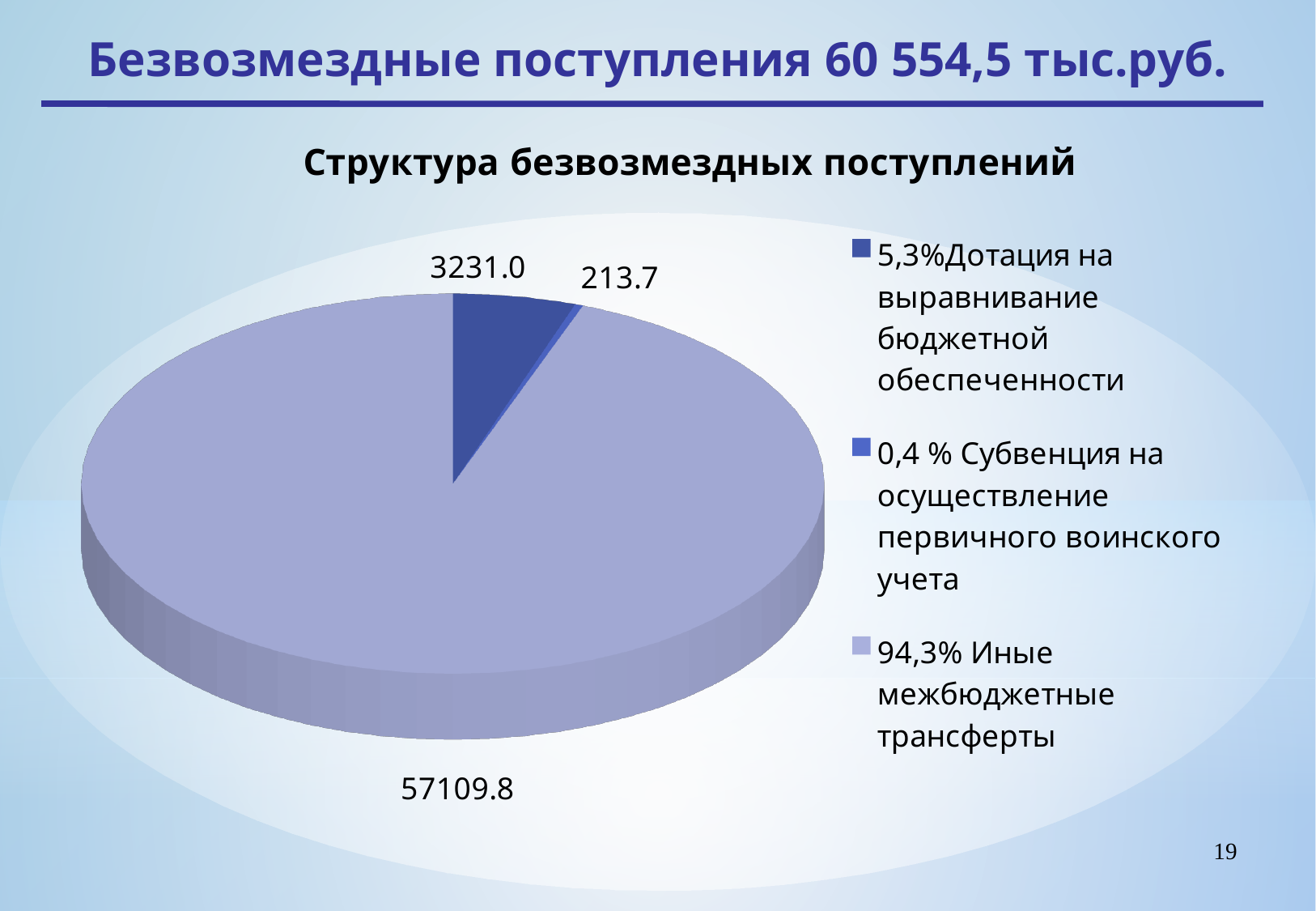
What is the title of the chart? Структура безвозмездных поступлений Which category has the smallest slice of the pie? Субвенция на осуществление первичного воинского учета What is the difference between the values for Дотация на выравнивание бюджетной обеспеченности and Субвенция на осуществление первичного воинского учета? 3017.3 What is the value of the slice for Субвенция на осуществление первичного воинского учета? 213.7 Which is larger: the value for Дотация на выравнивание бюджетной обеспеченности or the value for Субвенция на осуществление первичного воинского учета? Дотация на выравнивание бюджетной обеспеченности What share of the pie does Дотация на выравнивание бюджетной обеспеченности represent? 5,3% What kind of chart is shown on the slide? Pie chart What is the value of the slice for Иные межбюджетные трансферты? 57109.8 How many slices does the pie chart have? 3 Which category has the largest slice of the pie? Иные межбюджетные трансферты What share of the pie does Иные межбюджетные трансферты represent? 94,3% What is the value of the slice for Дотация на выравнивание бюджетной обеспеченности? 3231.0